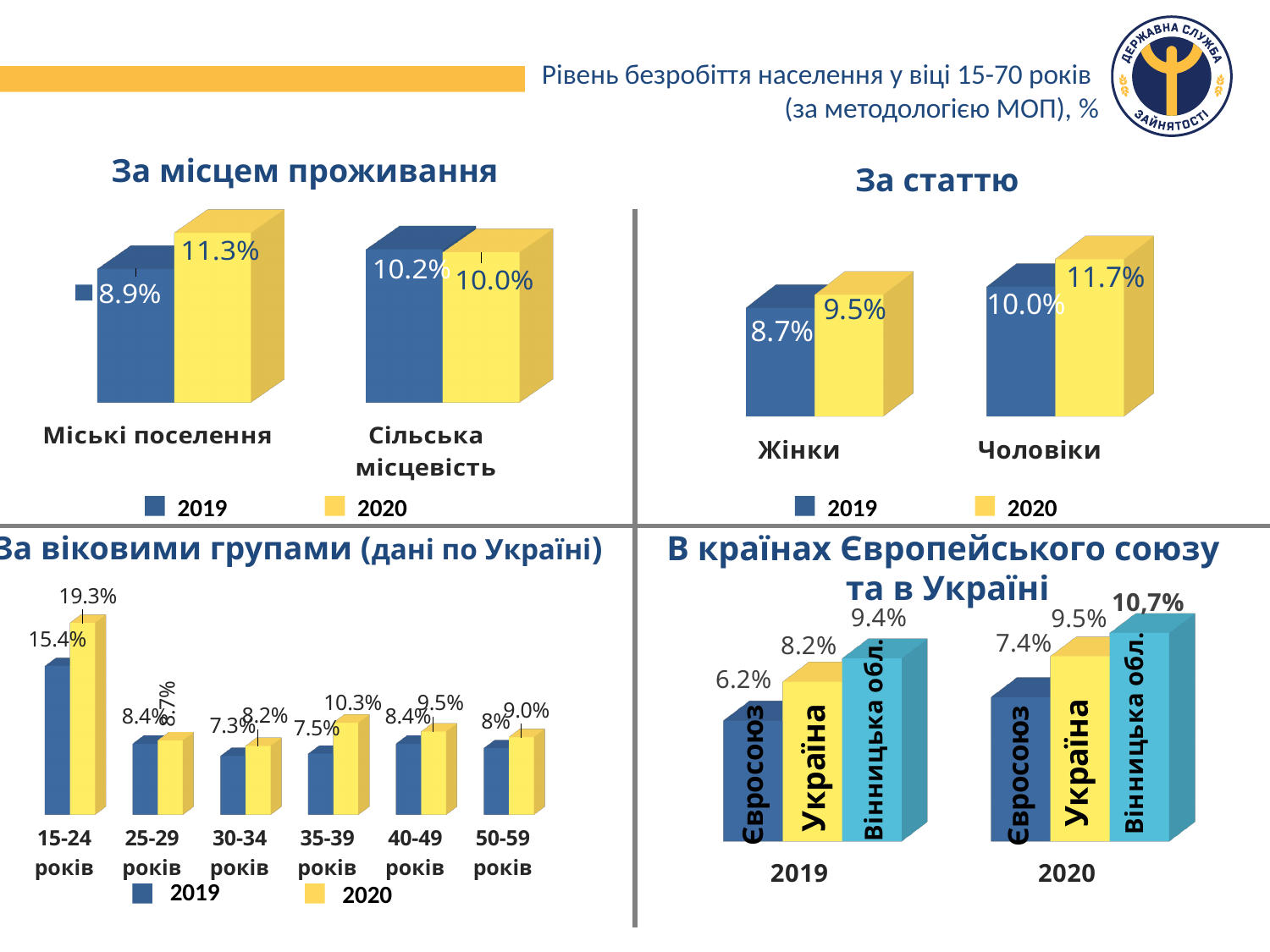
In the chart 'За віковими групами', how many age groups are shown? 6 In the chart 'За віковими групами', which age group has the highest 2020 value? 15-24 років In the chart 'За віковими групами', which age group has the lowest 2019 value? 30-34 років In the chart 'За місцем проживання', what is the value for Міські поселення in 2020? 11.3% In the chart 'В країнах Європейського союзу та в Україні', what is the value for Вінницька обл. in 2020? 10,7% In the chart 'В країнах Європейського союзу та в Україні', what is the difference between Україна and Євросоюз in 2019? 2.0% What kind of chart is 'За місцем проживання'? Bar chart In the chart 'За статтю', what is the value for Чоловіки in 2019? 10.0% In the chart 'За статтю', which category has the higher 2020 value, Жінки or Чоловіки? Чоловіки In the chart 'За віковими групами', what is the 2020 value for 35-39 років? 10.3% In the chart 'За статтю', how many series does the legend list? 2 In the chart 'За місцем проживання', what is the difference between the 2019 and 2020 values for Міські поселення? 2.4%